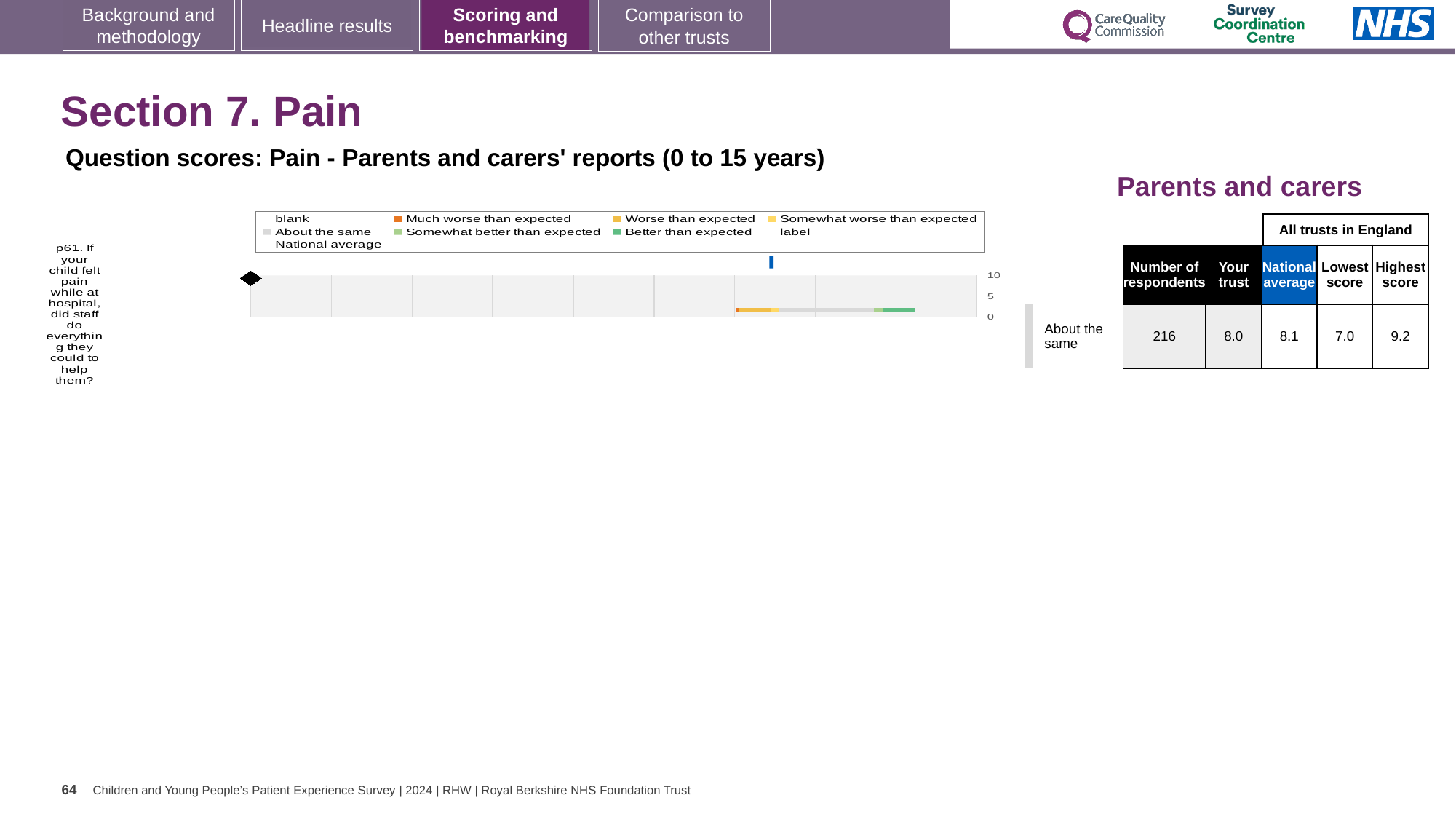
How many respondents answered question p61? 216 What is the highest value shown on the chart's score axis? 10 How many survey questions are plotted in the chart? 1 What is the difference between the highest score and the lowest score for question p61? 2.2 Which is larger for question p61: the 'Your trust' score or the national average? National average What is the highest score among all trusts in England for question p61? 9.2 Which benchmark category is the trust's result for question p61 placed in? About the same What kind of chart is shown on the slide? bar chart What colour represents 'Much worse than expected' in the chart legend? Orange What is the lowest score among all trusts in England for question p61? 7.0 What is the 'Your trust' score for question p61? 8.0 What is the national average score for question p61? 8.1